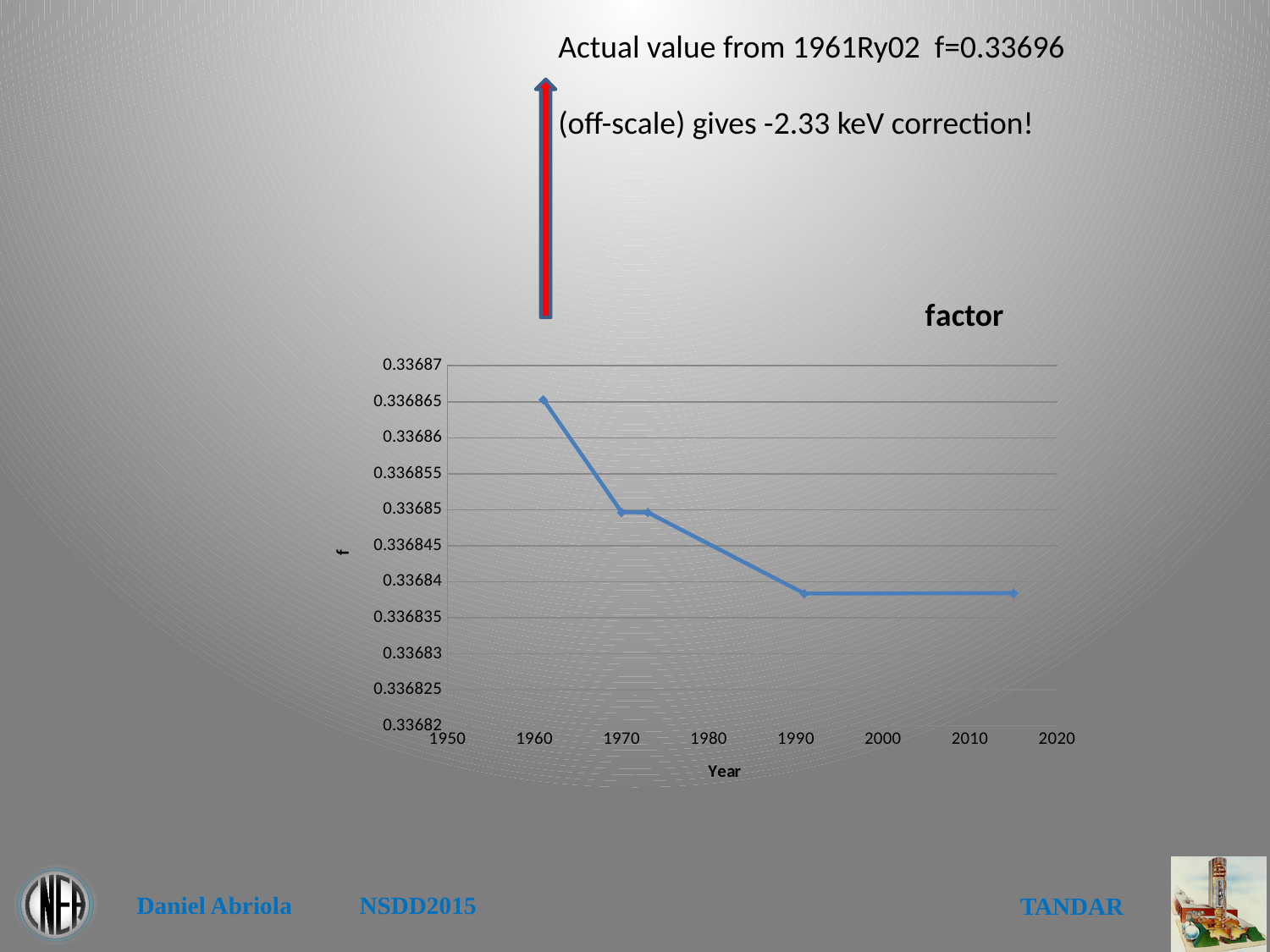
Which data point has the highest value of f, the one around 1961 or the one around 1991? the one around 1961 Is the value of f for the data point around 2015 greater or less than 0.33685? less Do the plotted values of f rise or fall as the year increases? fall What is the title of the chart? factor Is the value of f for the earliest data point (around 1961) greater or less than 0.33686? greater How many data points are plotted on the line? 5 What is the label of the x axis of the chart? Year Is the value of f for the data point around 1970 greater or less than 0.33686? less What is the lowest value shown on the y axis of the chart? 0.33682 What kind of chart is shown on the slide? line chart Around which year does the plotted line reach its highest value of f? 1961